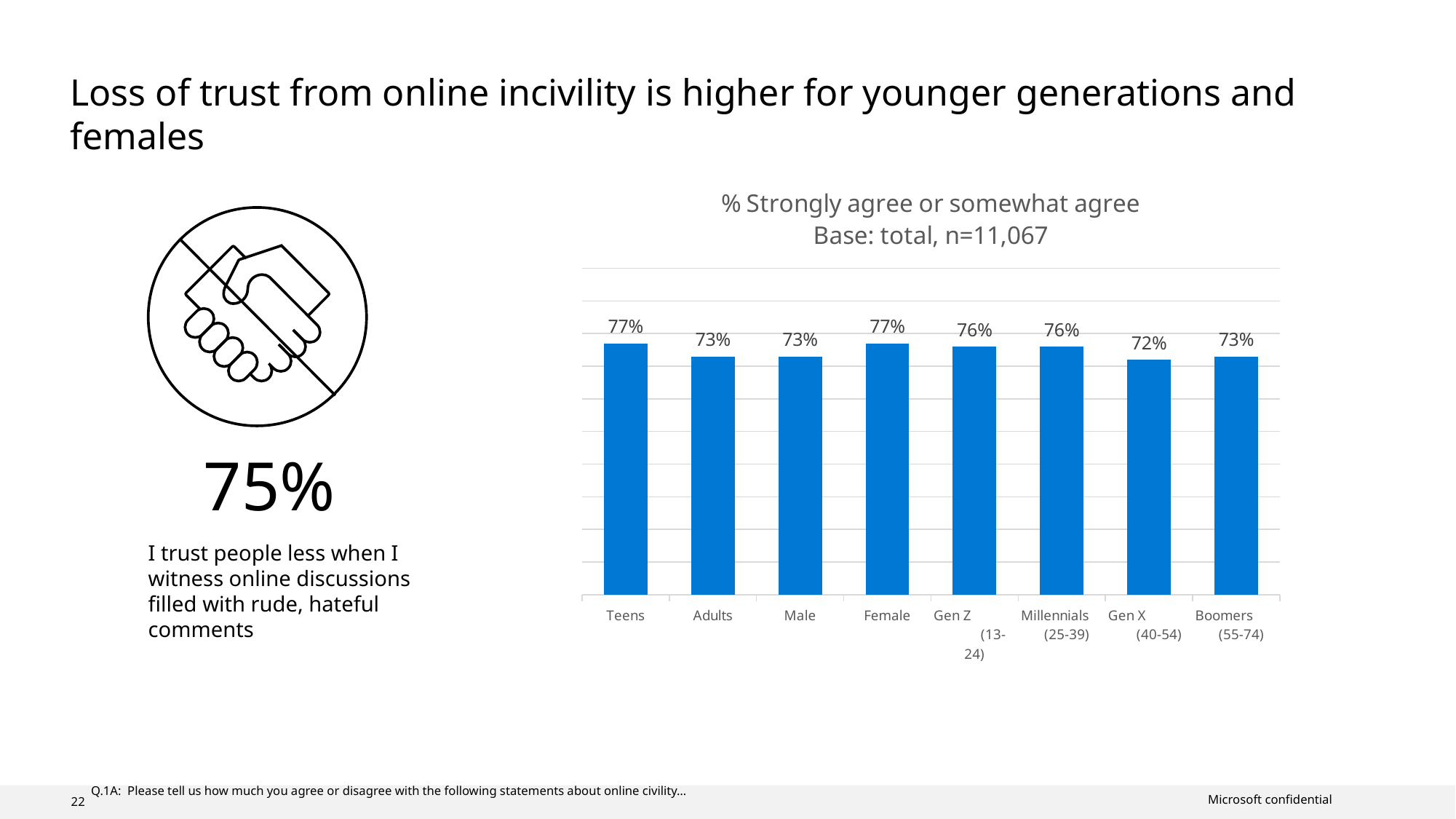
Which is larger, the value for Female or the value for Male? Female What is the difference between the values for Female and Male? 4% What is the value for Boomers (55-74)? 73% Which category has the lowest value? Gen X (40-54) What is the value for Teens? 77% What is the base size stated in the chart title? n=11,067 Which is larger, the value for Gen Z (13-24) or the value for Gen X (40-54)? Gen Z (13-24) How many categories are shown in the bar chart? 8 What is the value for Gen X (40-54)? 72% What kind of chart is shown on the slide? Bar chart What is the value for Millennials (25-39)? 76% What is the difference between the values for Teens and Adults? 4%